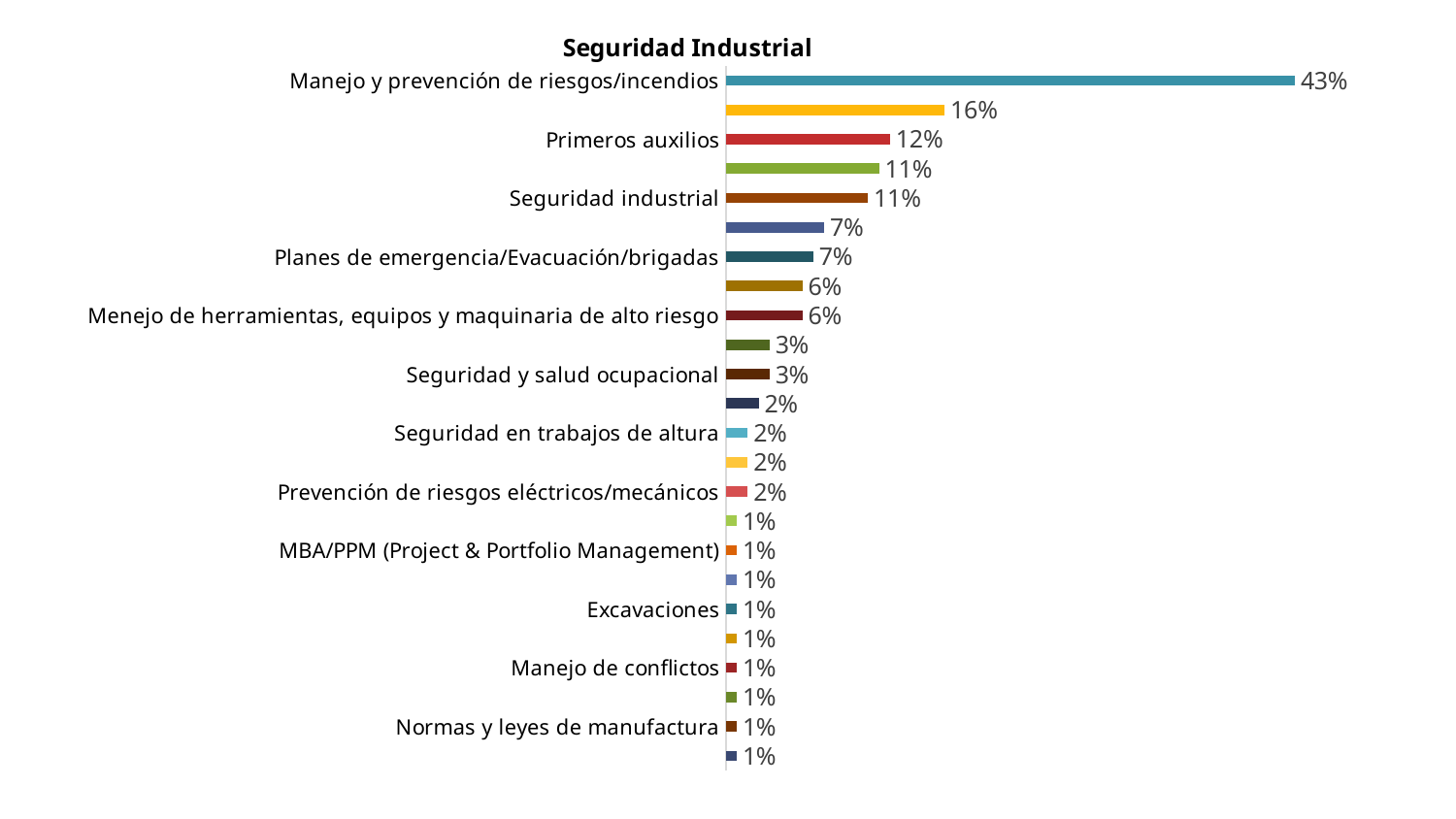
What is the value for Excavaciones? 1% Which category has the highest value? Manejo y prevención de riesgos/incendios How many bars are plotted in the chart? 24 What is the title of the chart? Seguridad Industrial Do the bar values increase or decrease from the top of the chart to the bottom? decrease Which is larger, the value for Primeros auxilios or the value for Seguridad industrial? Primeros auxilios What is the value for Primeros auxilios? 12% What is the value for Seguridad y salud ocupacional? 3% What kind of chart is shown on the slide? bar chart What is the difference between the values for Manejo y prevención de riesgos/incendios and Primeros auxilios? 31 percentage points What is the value for Manejo y prevención de riesgos/incendios? 43% What is the value for Planes de emergencia/Evacuación/brigadas? 7%